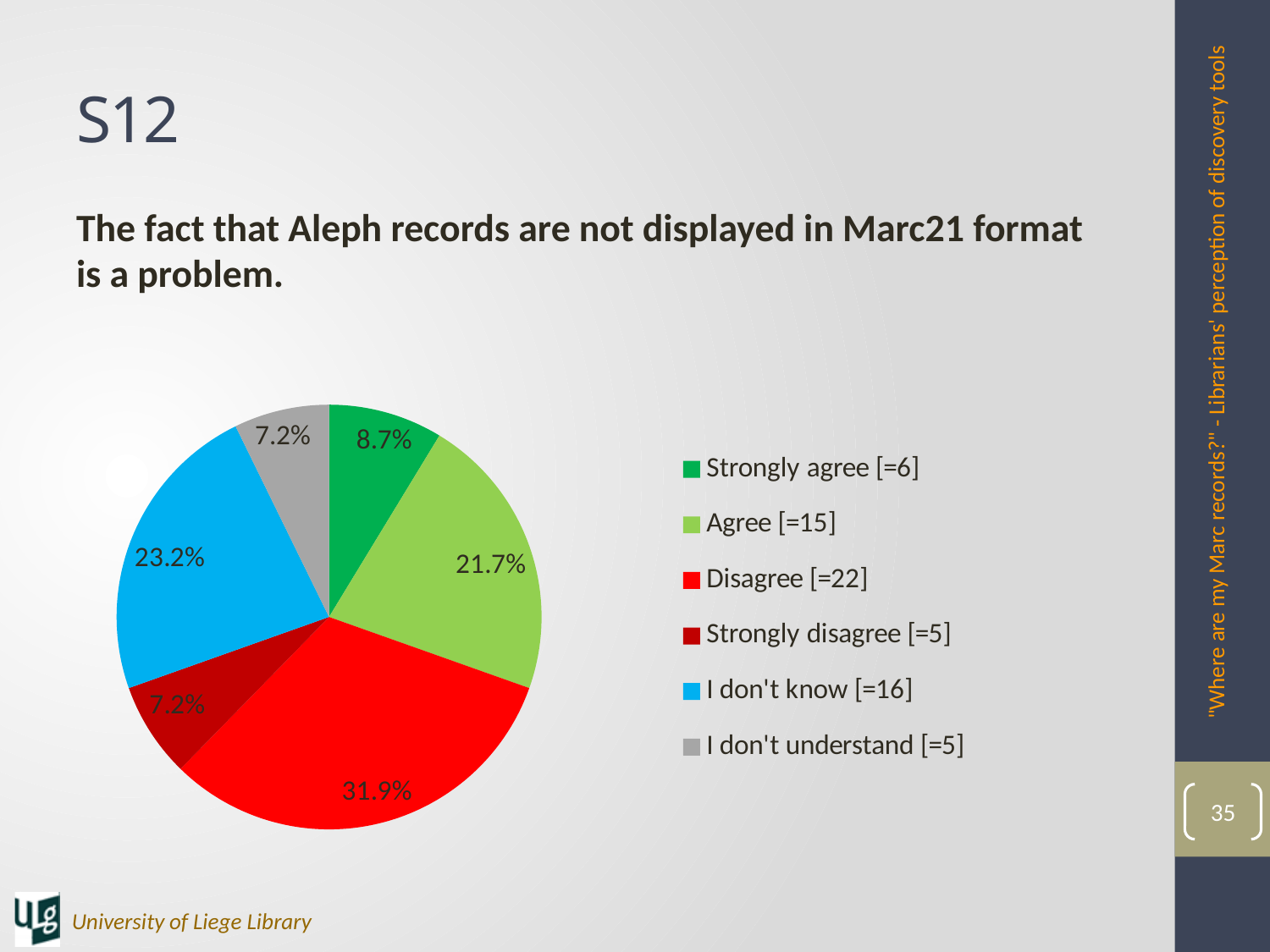
What percentage of the pie is the Disagree slice? 31.9% What colour is the Disagree slice in the pie chart? red How many categories does the pie chart have? 6 Which slice is larger: Agree or I don't know? I don't know What is the difference in percentage points between the Disagree slice and the Agree slice? 10.2 Which response category has the largest slice of the pie? Disagree How many respondents chose Disagree, according to the legend? 22 How many respondents chose I don't know, according to the legend? 16 What percentage of the pie is the Agree slice? 21.7% What percentage of the pie is the Strongly agree slice? 8.7% What kind of chart is shown on the slide? pie chart